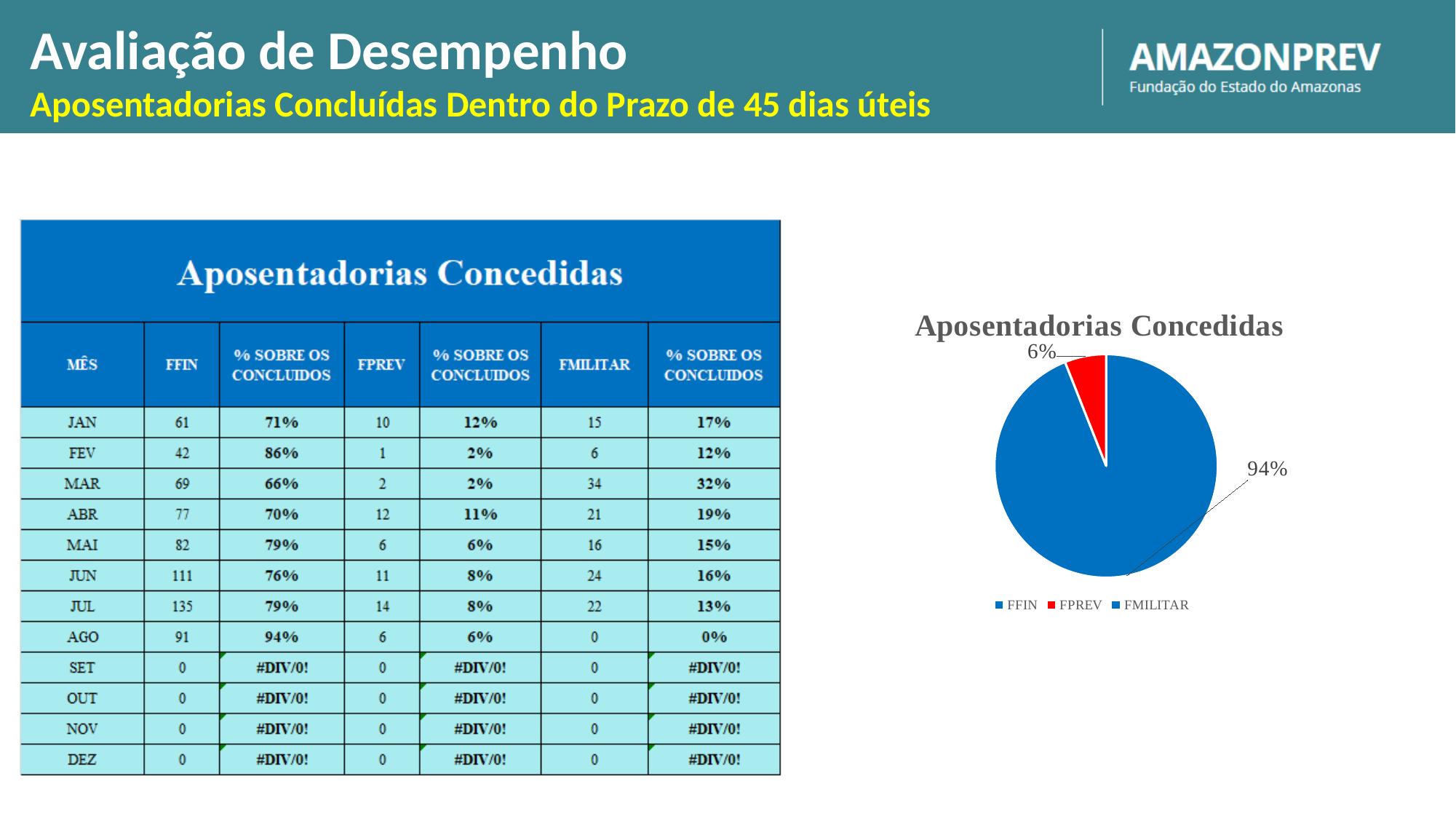
In the pie chart, which is larger: the FFIN slice or the FPREV slice? FFIN What kind of chart is shown on the right of the slide? pie chart What is the difference in percentage points between the FFIN slice and the FPREV slice in the pie chart? 88% Of the two labelled slices in the pie chart, which is smaller? FPREV How many entries does the pie chart's legend list? 3 What is the title of the pie chart? Aposentadorias Concedidas What share of the pie chart does FPREV represent? 6% Is the FFIN share in the pie chart greater or less than 50%? greater Which category has the largest slice in the pie chart? FFIN What share of the pie chart does FFIN represent? 94% What colour is the FPREV slice in the pie chart? red